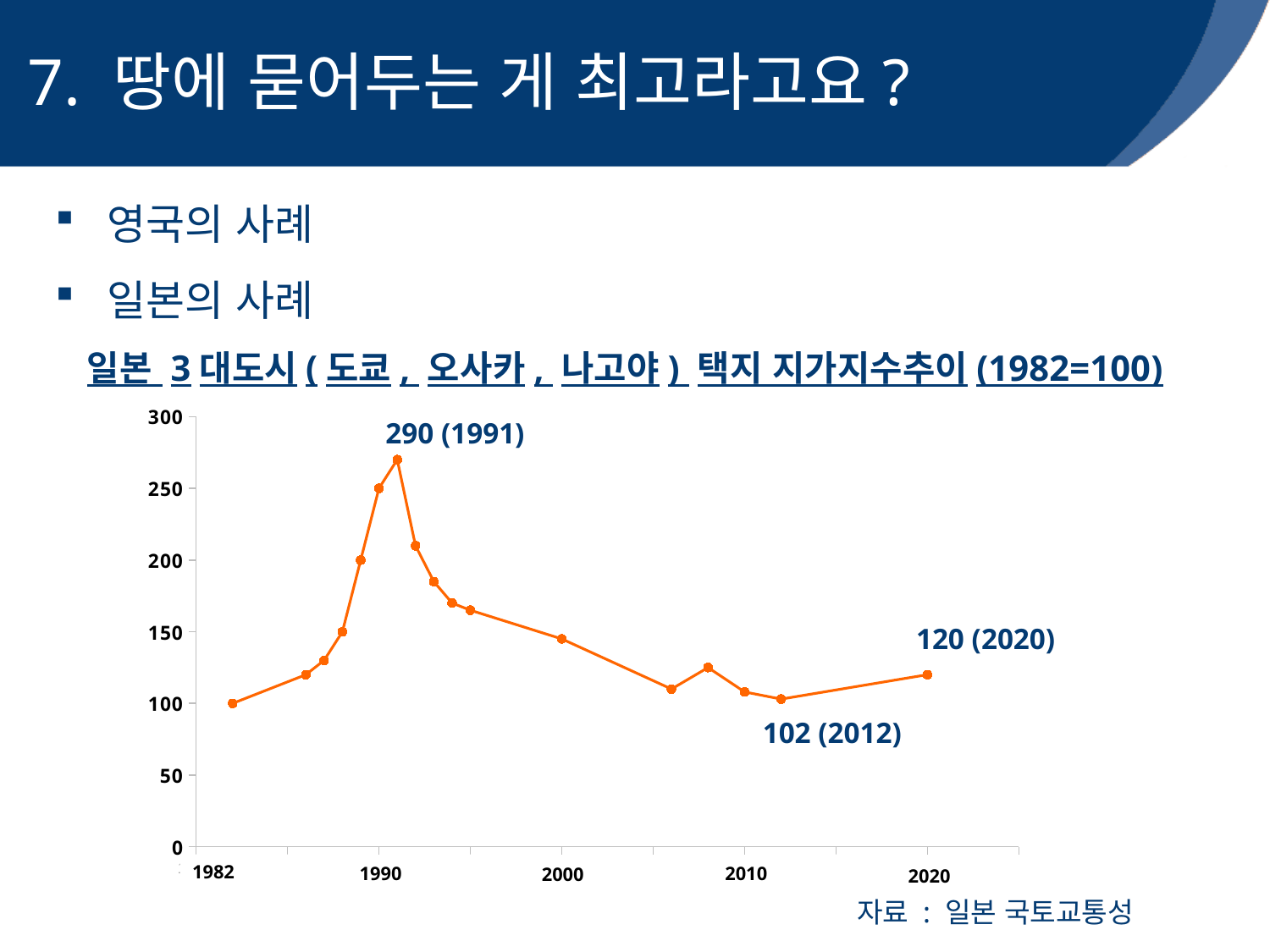
Does the land price index rise or fall between 1991 and 2012? fall What is the land price index value labelled for 2012? 102 Which year has the larger index value, 1991 or 2020? 1991 What is the difference between the labelled values for 1991 and 2020? 170 What is the difference between the labelled values for 2020 and 2012? 18 Is the value for 2010 greater or less than 150? less What is the land price index value labelled for 2020? 120 What kind of chart is shown on the slide? line chart According to the note at the bottom of the slide, what is the data source of the chart? 일본 국토교통성 In which year does the land price index reach its highest point? 1991 What is the land price index value labelled for 1991? 290 Is the value for 1990 greater or less than 200? greater